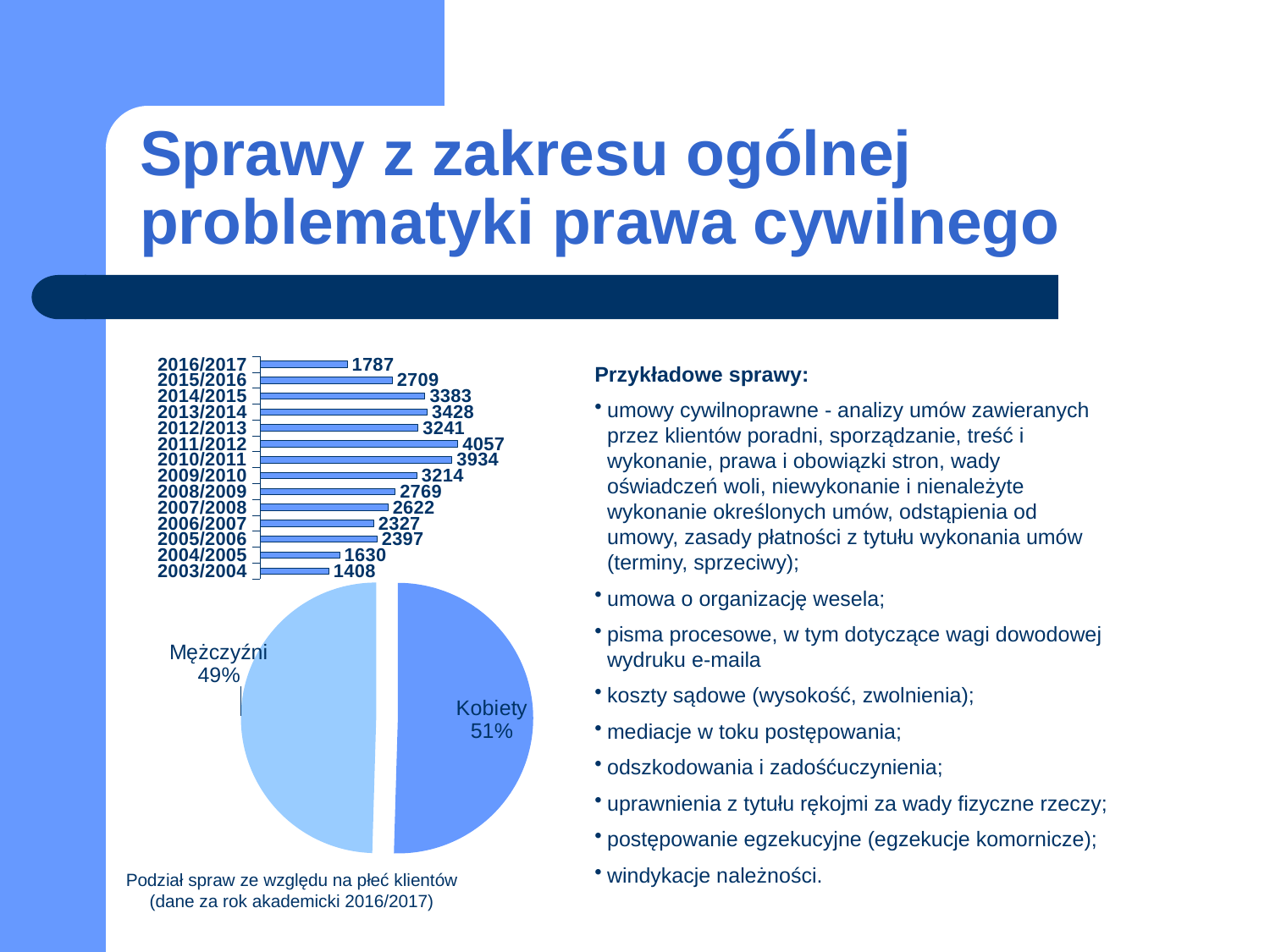
In the bar chart at the top left of the slide, which is larger: the value for 2014/2015 or the value for 2015/2016? 2014/2015 In the bar chart at the top left of the slide, what is the value for 2011/2012? 4057 What kind of chart is the chart at the top left of the slide? bar chart In the bar chart at the top left of the slide, which academic year has the highest value? 2011/2012 In the pie chart on the slide, what share of cases is for Kobiety? 51% In the bar chart at the top left of the slide, what is the difference between the values for 2010/2011 and 2009/2010? 720 What kind of chart is the chart below the bar chart on the slide? pie chart In the bar chart at the top left of the slide, what is the value for 2016/2017? 1787 In the bar chart at the top left of the slide, what is the difference between the values for 2011/2012 and 2003/2004? 2649 In the pie chart on the slide, what share of cases is for Mężczyźni? 49% In the bar chart at the top left of the slide, which academic year has the lowest value? 2003/2004 In the bar chart at the top left of the slide, how many academic years are shown? 14